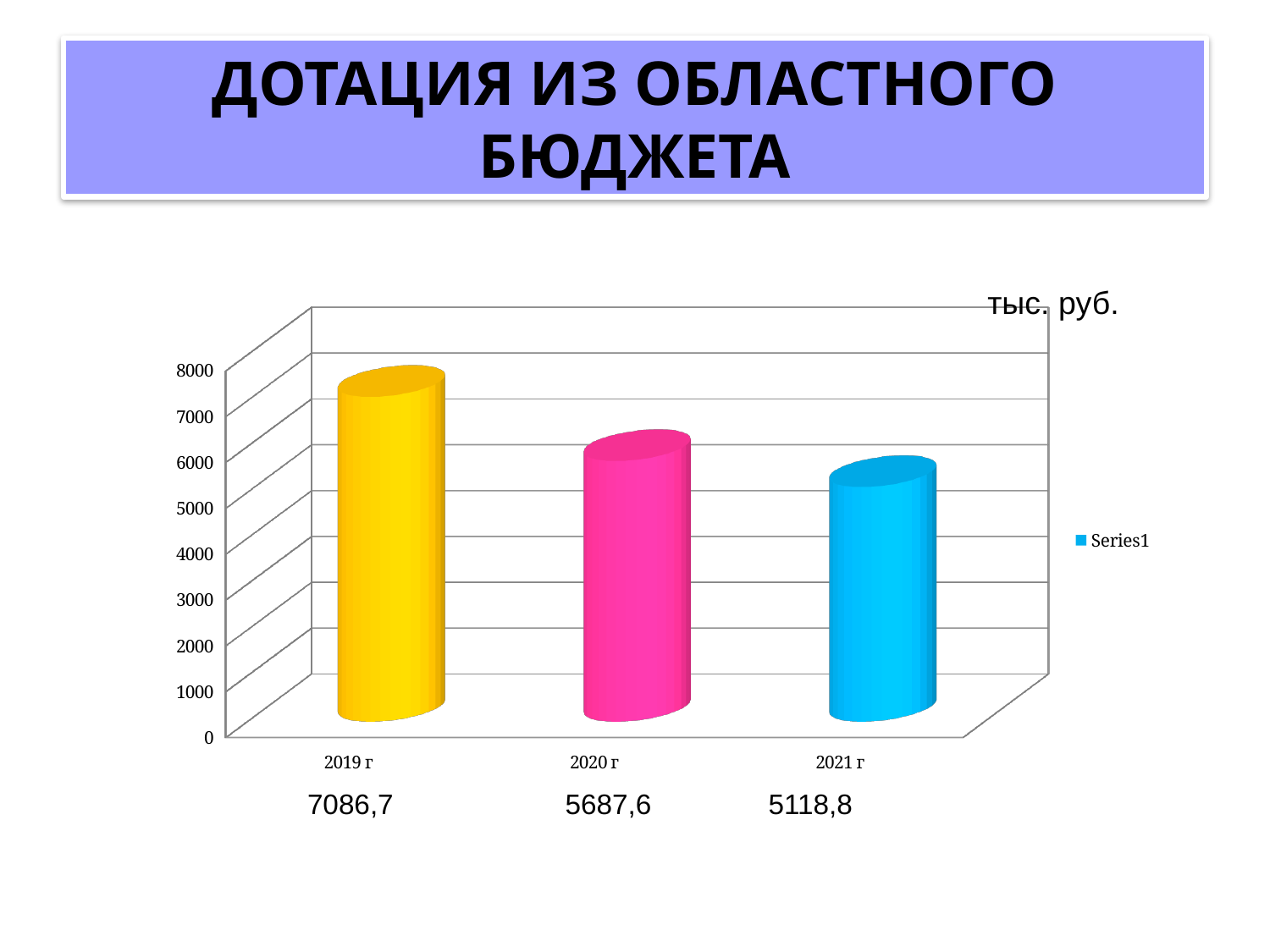
Which year has the lowest value? 2021 г Do the values rise or fall from 2019 г to 2021 г? fall What is the value for 2020 г? 5687,6 Which year has the highest value? 2019 г Which is larger, the value for 2020 г or the value for 2021 г? 2020 г Is the value for 2019 г greater or less than 7000? greater How many years are shown on the chart? 3 What kind of chart is shown on the slide? bar chart What is the value for 2021 г? 5118,8 What is the value for 2019 г? 7086,7 What is the difference between the values for 2020 г and 2021 г? 568,8 What is the difference between the values for 2019 г and 2020 г? 1399,1